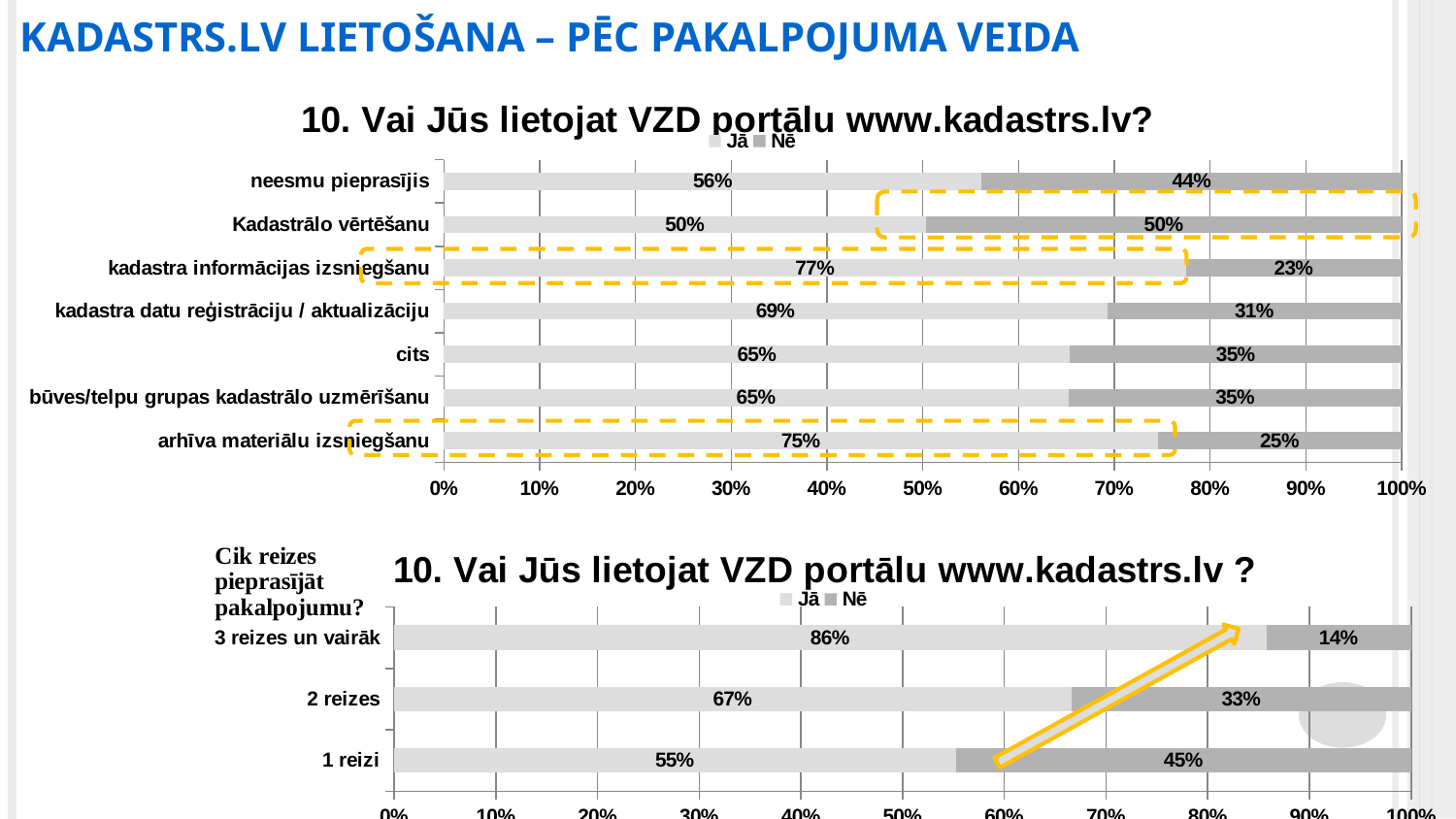
In the top chart, which category has the highest 'Jā' value? kadastra informācijas izsniegšanu In the bottom chart, how many series does the legend list? 2 In the bottom chart, what is the 'Nē' value for '1 reizi'? 45% In the top chart, what is the 'Nē' value for 'neesmu pieprasījis'? 44% In the top chart, which category has the lowest 'Jā' value? Kadastrālo vērtēšanu In the top chart, what is the difference between the 'Jā' values for 'arhīva materiālu izsniegšanu' and 'kadastra datu reģistrāciju / aktualizāciju'? 6 percentage points In the top chart, what is the total of the stacked bar for 'cits'? 100% In the bottom chart, what is the 'Jā' value for '3 reizes un vairāk'? 86% In the bottom chart, is the 'Jā' value for '2 reizes' larger or the 'Jā' value for '1 reizi'? 2 reizes What type of chart is the bottom chart? Stacked bar chart In the top chart, what is the 'Jā' value for 'kadastra informācijas izsniegšanu'? 77% In the top chart, how many categories are shown? 7